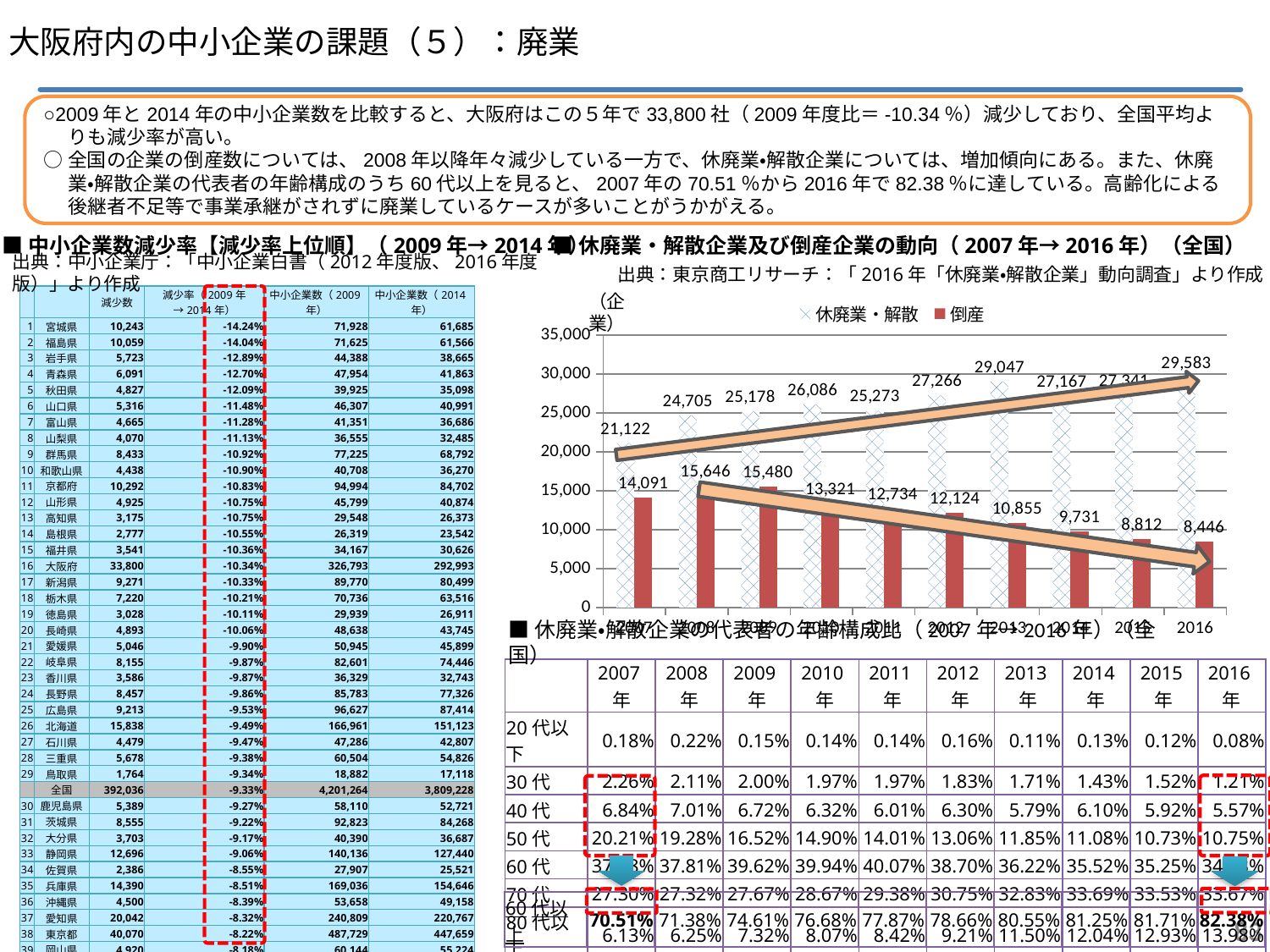
In the 休廃業・解散企業及び倒産企業の動向 chart, what is the value of 倒産 for the first year shown (2007)? 14,091 In the 休廃業・解散企業及び倒産企業の動向 chart, is the 倒産 value for 2016 greater or less than 10,000? less In the 休廃業・解散企業及び倒産企業の動向 chart, what is the value of 休廃業・解散 for 2016? 29,583 In the 休廃業・解散企業及び倒産企業の動向 chart, which year has the lowest 倒産 value? 2016 What type of chart is used in the 休廃業・解散企業及び倒産企業の動向 chart? bar chart In the 休廃業・解散企業及び倒産企業の動向 chart, does the 倒産 series rise or fall from 2007 to 2016? fall In the 休廃業・解散企業及び倒産企業の動向 chart, what is the difference between the 休廃業・解散 and 倒産 values for 2016? 21,137 How many series does the legend of the 休廃業・解散企業及び倒産企業の動向 chart list? 2 How many years are plotted on the x axis of the 休廃業・解散企業及び倒産企業の動向 chart? 10 In the 休廃業・解散企業及び倒産企業の動向 chart, what is the value of 休廃業・解散 for the first year shown (2007)? 21,122 In the 休廃業・解散企業及び倒産企業の動向 chart, what is the value of 倒産 for 2016? 8,446 In the 休廃業・解散企業及び倒産企業の動向 chart, which year has the highest 休廃業・解散 value? 2016